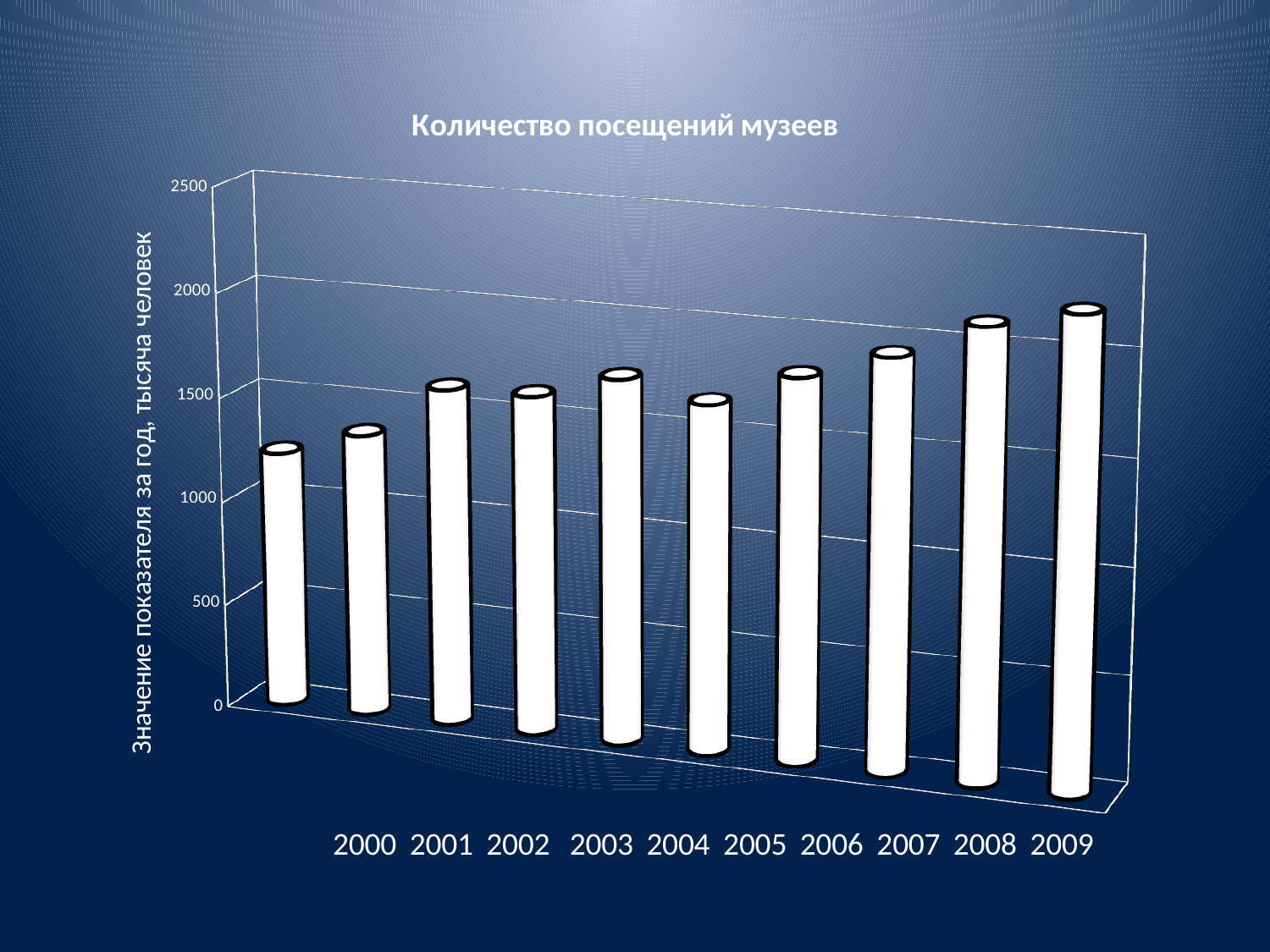
Is the value for 2000 greater or less than 1500? less Is the value for 2000 greater or less than 1000? greater What is the title of the chart? Количество посещений музеев What kind of chart is shown on the slide? bar chart Do the values generally rise or fall from 2000 to 2009? rise What is the label of the vertical axis? Значение показателя за год, тысяча человек Which year has the lowest number of museum visits? 2000 Which is larger, the value for 2009 or the value for 2000? 2009 Which year has the highest number of museum visits? 2009 How many years are shown on the x axis of the chart? 10 Is the value for 2009 greater or less than 1500? greater